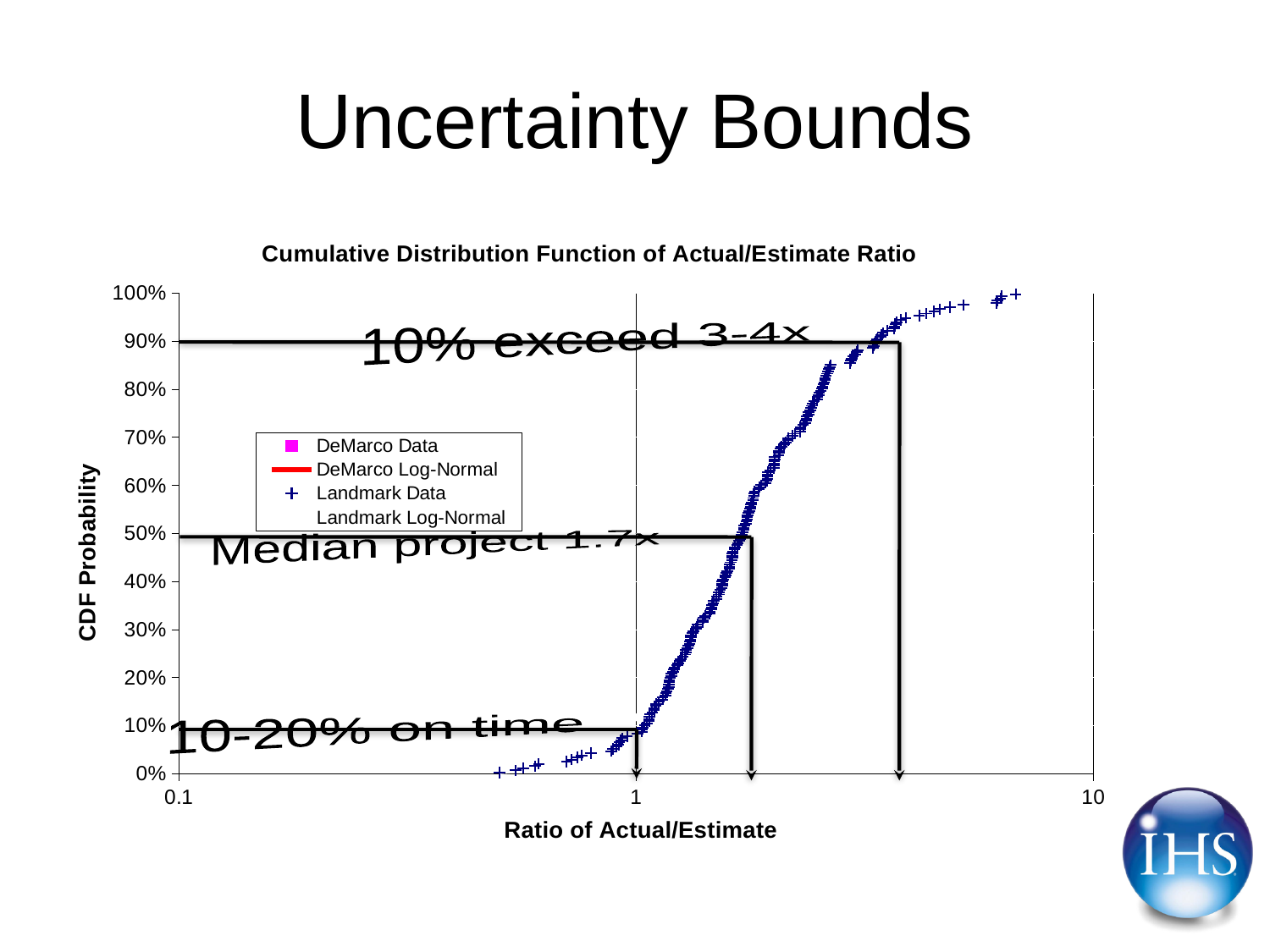
What kind of chart is shown on the slide? scatter chart According to the annotation on the chart, what is the Actual/Estimate ratio of the median project? 1.7x What is the lowest value shown on the x axis of the chart? 0.1 According to the annotation on the chart, what percentage of projects exceed 3-4x? 10% What is the highest value shown on the x axis of the chart? 10 How many series does the chart's legend list? 4 Is the CDF probability at a Ratio of Actual/Estimate of 1 greater or less than 50%? less Is the CDF probability at the median project ratio of 1.7x greater or less than 20%? greater According to the annotation on the chart, what percentage of projects are on time? 10-20% Do the plotted CDF values rise or fall as the Ratio of Actual/Estimate increases? rise Which legend entry is plotted with + markers? Landmark Data What is the title of the chart? Cumulative Distribution Function of Actual/Estimate Ratio